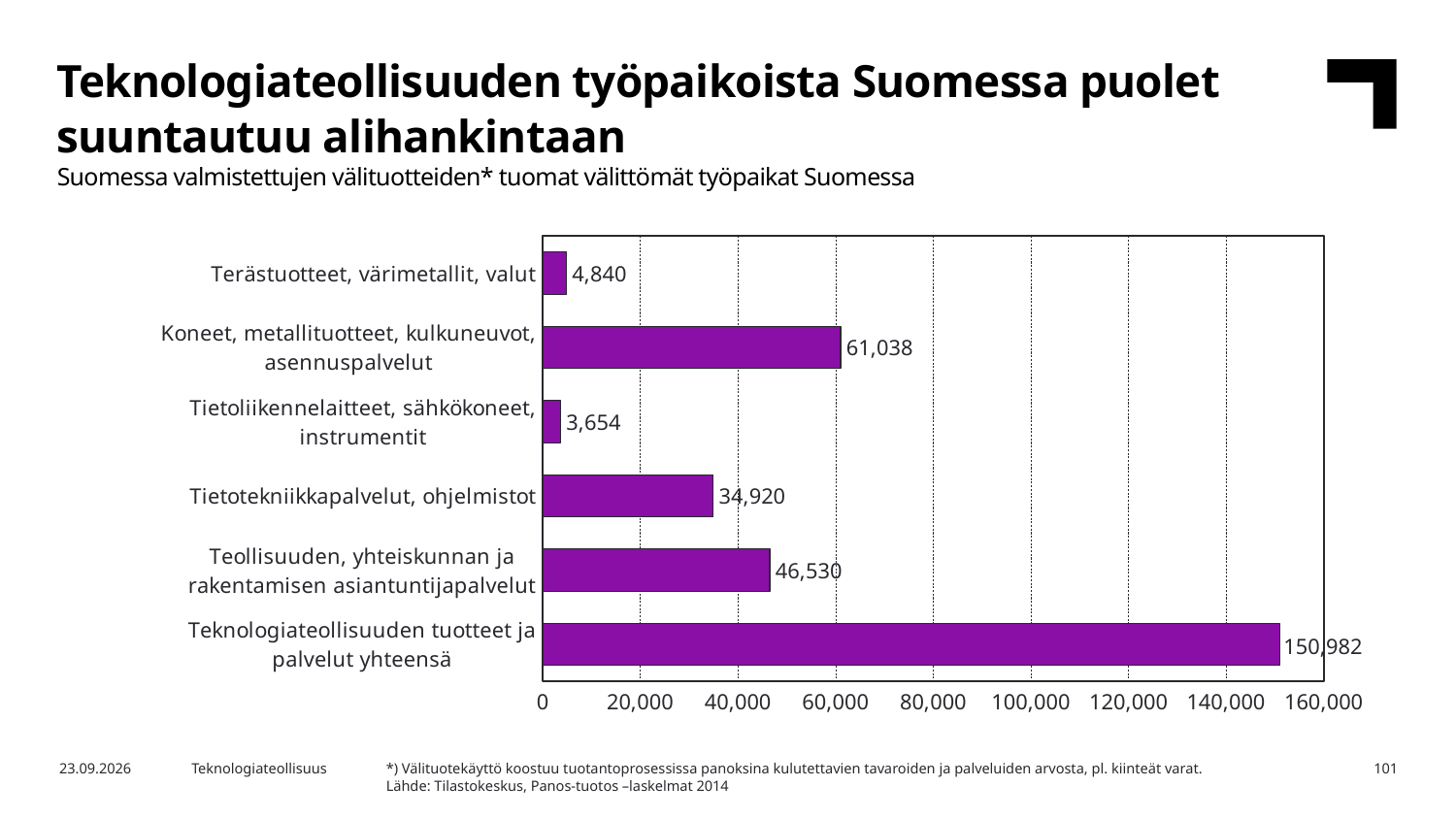
What is the value for Tietoliikennelaitteet, sähkökoneet, instrumentit? 3,654 What is the value for Tietotekniikkapalvelut, ohjelmistot? 34,920 How many categories are shown in the chart? 6 What is the difference between the values for Koneet, metallituotteet, kulkuneuvot, asennuspalvelut and Teollisuuden, yhteiskunnan ja rakentamisen asiantuntijapalvelut? 14,508 Which is larger: the value for Teollisuuden, yhteiskunnan ja rakentamisen asiantuntijapalvelut or the value for Tietotekniikkapalvelut, ohjelmistot? Teollisuuden, yhteiskunnan ja rakentamisen asiantuntijapalvelut What is the value for Koneet, metallituotteet, kulkuneuvot, asennuspalvelut? 61,038 What kind of chart is shown on the slide? bar chart What is the difference between the values for Terästuotteet, värimetallit, valut and Tietoliikennelaitteet, sähkökoneet, instrumentit? 1,186 Is the value for Koneet, metallituotteet, kulkuneuvot, asennuspalvelut greater or less than 60,000? greater What is the value for Teknologiateollisuuden tuotteet ja palvelut yhteensä? 150,982 Which category has the lowest value? Tietoliikennelaitteet, sähkökoneet, instrumentit Which category has the highest value? Teknologiateollisuuden tuotteet ja palvelut yhteensä